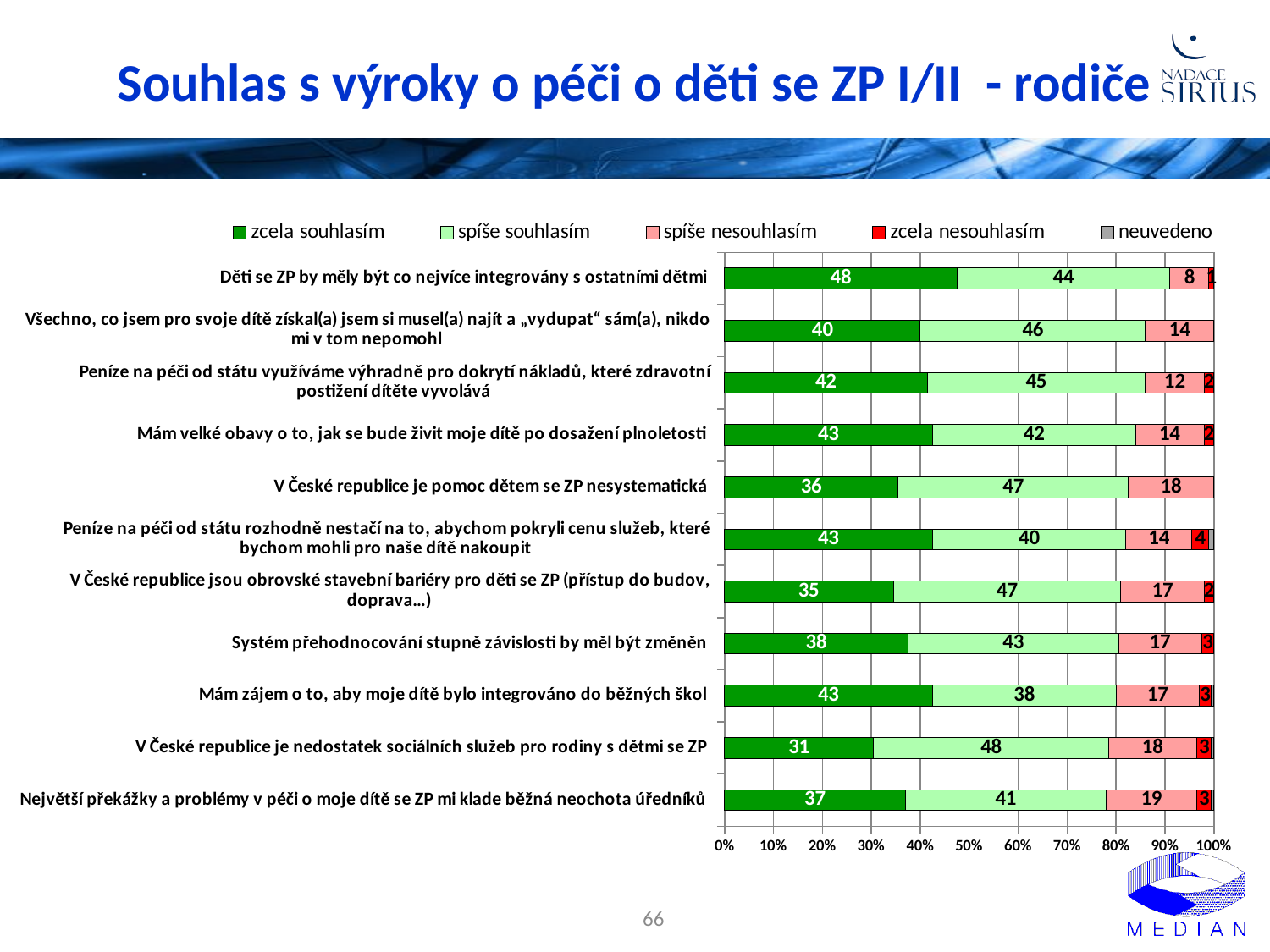
Which legend entry is shown in dark green? zcela souhlasím How many series does the legend list? 5 What is the "zcela nesouhlasím" value for "Peníze na péči od státu rozhodně nestačí na to, abychom pokryli cenu služeb, které bychom mohli pro naše dítě nakoupit"? 4 Which is larger for "Mám zájem o to, aby moje dítě bylo integrováno do běžných škol": the "zcela souhlasím" value or the "spíše souhlasím" value? zcela souhlasím What is the "zcela souhlasím" value for "Děti se ZP by měly být co nejvíce integrovány s ostatními dětmi"? 48 What kind of chart is shown on the slide? Stacked bar chart What is the "spíše souhlasím" value for "V České republice je nedostatek sociálních služeb pro rodiny s dětmi se ZP"? 48 What is the difference between the "zcela souhlasím" and "spíše souhlasím" values for "V České republice je pomoc dětem se ZP nesystematická"? 11 How many statements (categories) are shown in the chart? 11 Which statement has the lowest "zcela souhlasím" value? V České republice je nedostatek sociálních služeb pro rodiny s dětmi se ZP Which statement has the highest "zcela souhlasím" value? Děti se ZP by měly být co nejvíce integrovány s ostatními dětmi What is the "spíše nesouhlasím" value for "Největší překážky a problémy v péči o moje dítě se ZP mi klade běžná neochota úředníků"? 19